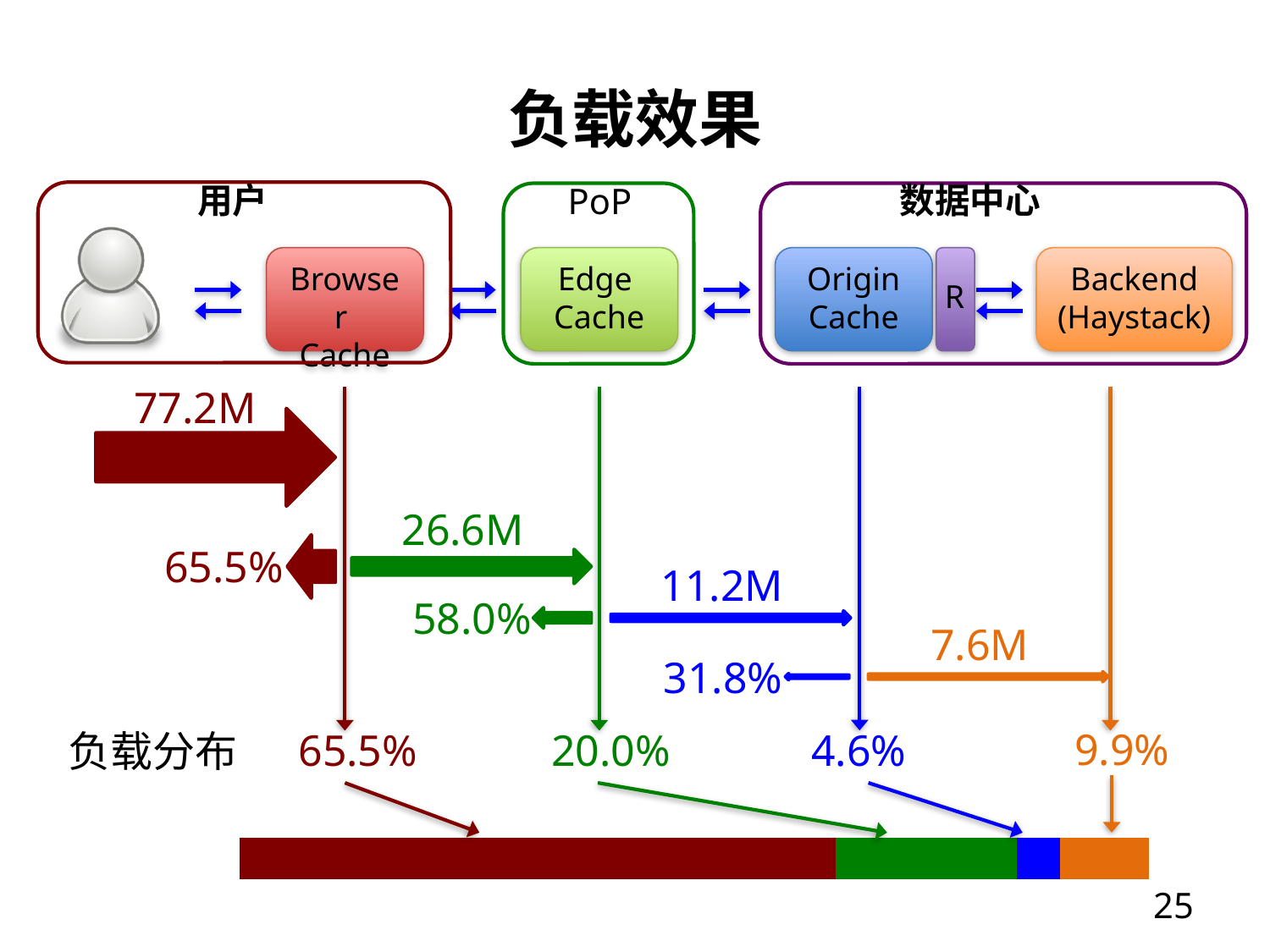
In the load distribution bar, what share of the load is handled by the Origin Cache? 4.6% What is the difference in percentage points between the Browser Cache share (65.5%) and the Edge Cache share (20.0%) of the load? 45.5 percentage points Which layer handles the largest share of the load in the load distribution bar? Browser Cache What is the total request volume entering the Browser Cache, as shown by the large dark red arrow? 77.2M In the load distribution bar, what share of the load is handled by the Backend (Haystack)? 9.9% How many segments does the load distribution bar at the bottom have? 4 Which layer handles the smallest share of the load in the load distribution bar? Origin Cache Which handles a larger share of the load, the Backend (Haystack) or the Origin Cache? Backend (Haystack) What is the hit rate shown for the Edge Cache? 58.0% In the load distribution (负载分布) bar at the bottom, what share of the load is handled by the Browser Cache? 65.5% What kind of chart is the load distribution graphic at the bottom of the slide? Stacked bar chart In the load distribution bar, what share of the load is handled by the Edge Cache? 20.0%